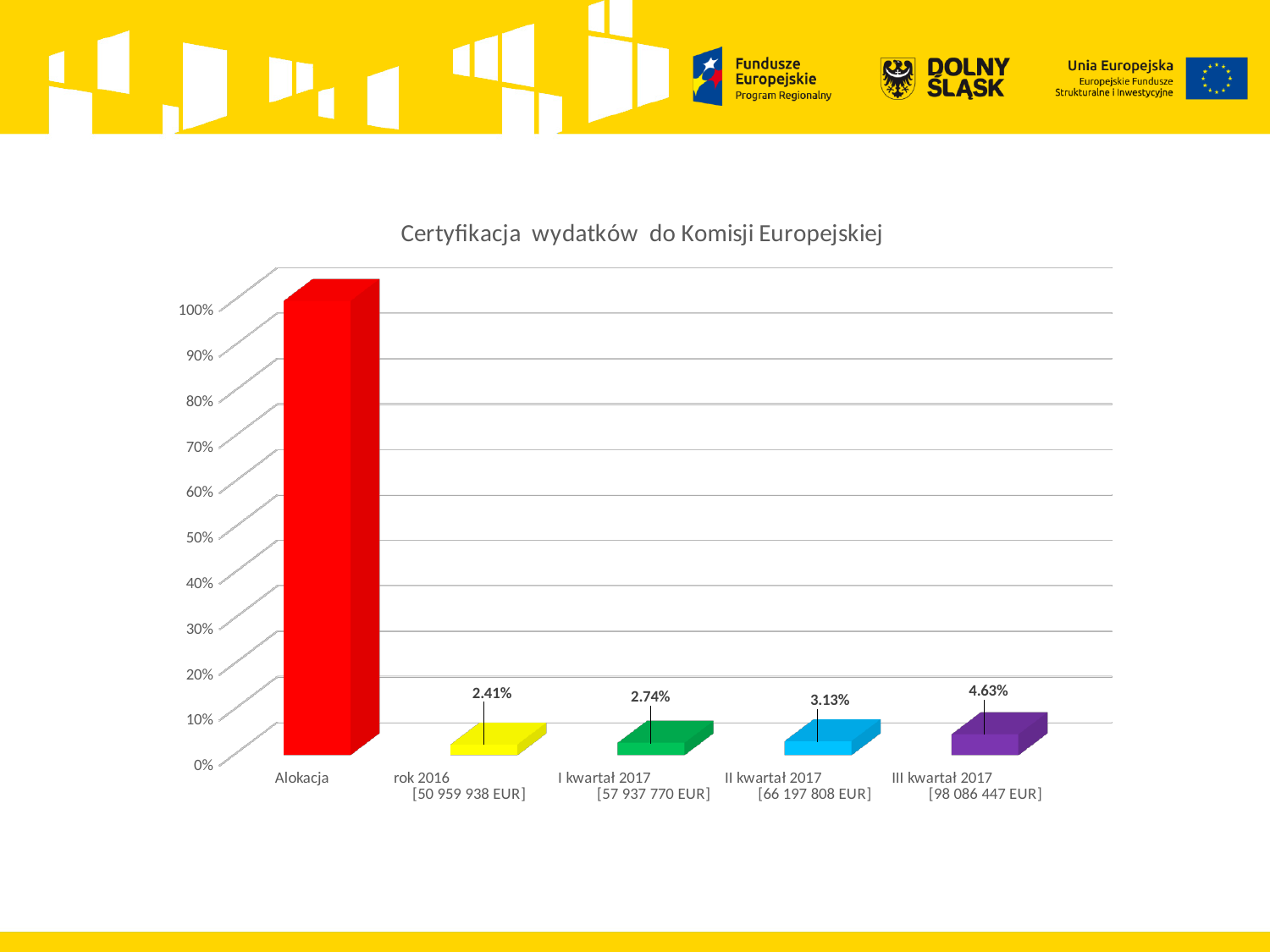
What is the value for II kwartał 2017? 3.13% What kind of chart is this? bar chart How many categories are shown on the x axis? 5 Which is larger, the value for II kwartał 2017 or the value for I kwartał 2017? II kwartał 2017 Which category has the highest value? Alokacja What is the value for rok 2016? 2.41% What is the value for III kwartał 2017? 4.63% Which category has the lowest value? rok 2016 Is the value for Alokacja greater or less than 90%? greater What is the value for I kwartał 2017? 2.74% What is the title of the chart? Certyfikacja wydatków do Komisji Europejskiej What is the difference between the values for III kwartał 2017 and rok 2016? 2.22%